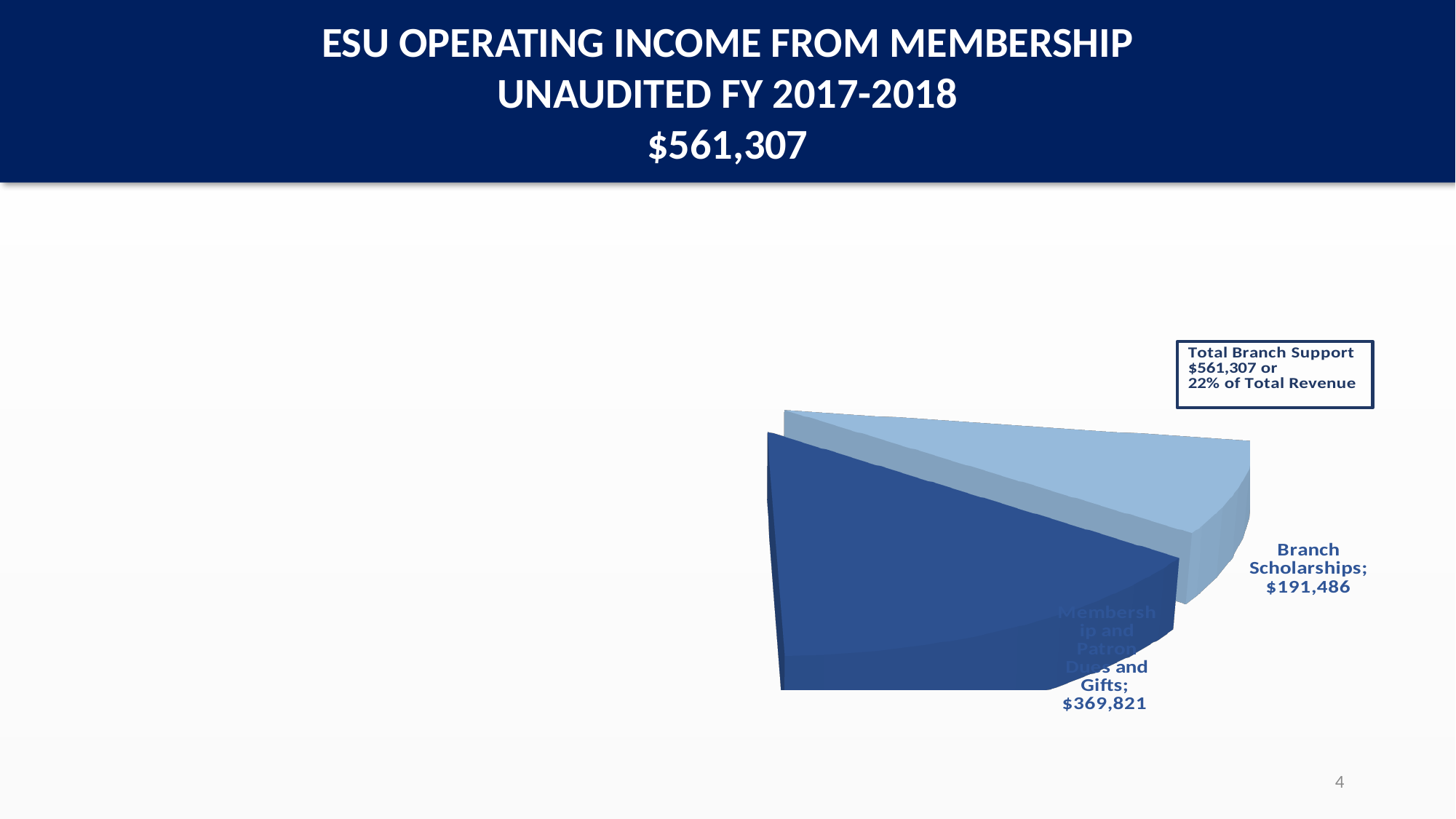
What is the difference between Membership and Patron Dues and Gifts and Branch Scholarships? $178,335 What fiscal year does the chart title refer to? FY 2017-2018 How many slices does the pie chart have? 2 What is the value for Branch Scholarships? $191,486 Which slice of the pie is the smallest? Branch Scholarships What is the value for Membership and Patron Dues and Gifts? $369,821 According to the text box on the chart, what percentage of total revenue is Total Branch Support? 22% Which slice of the pie is the largest? Membership and Patron Dues and Gifts What is the total of the two slices in the pie chart? $561,307 Which is larger, Membership and Patron Dues and Gifts or Branch Scholarships? Membership and Patron Dues and Gifts What type of chart is shown on the slide? Pie chart